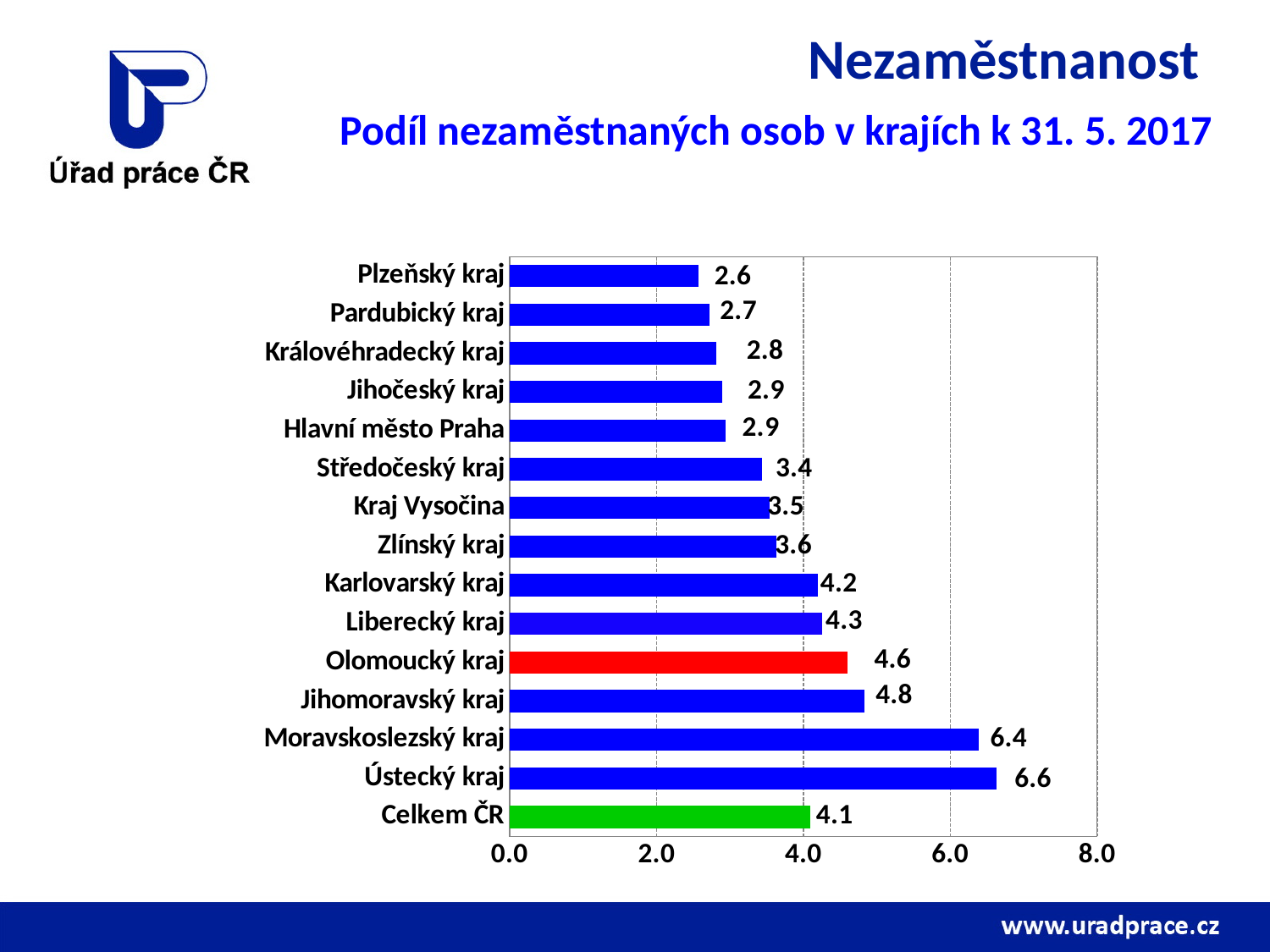
What is the value for Moravskoslezský kraj? 6.4 How many bars are shown in the chart? 15 Which bar is coloured red? Olomoucký kraj Is the value for Středočeský kraj greater or less than 4.0? less What is the difference between the values for Ústecký kraj and Plzeňský kraj? 4.0 Which region has the highest value? Ústecký kraj Which region has the lowest value? Plzeňský kraj What is the value for Olomoucký kraj? 4.6 What is the difference between the values for Olomoucký kraj and Celkem ČR? 0.5 Which is larger, the value for Jihomoravský kraj or the value for Karlovarský kraj? Jihomoravský kraj What type of chart is shown on the slide? bar chart What is the value for Celkem ČR? 4.1